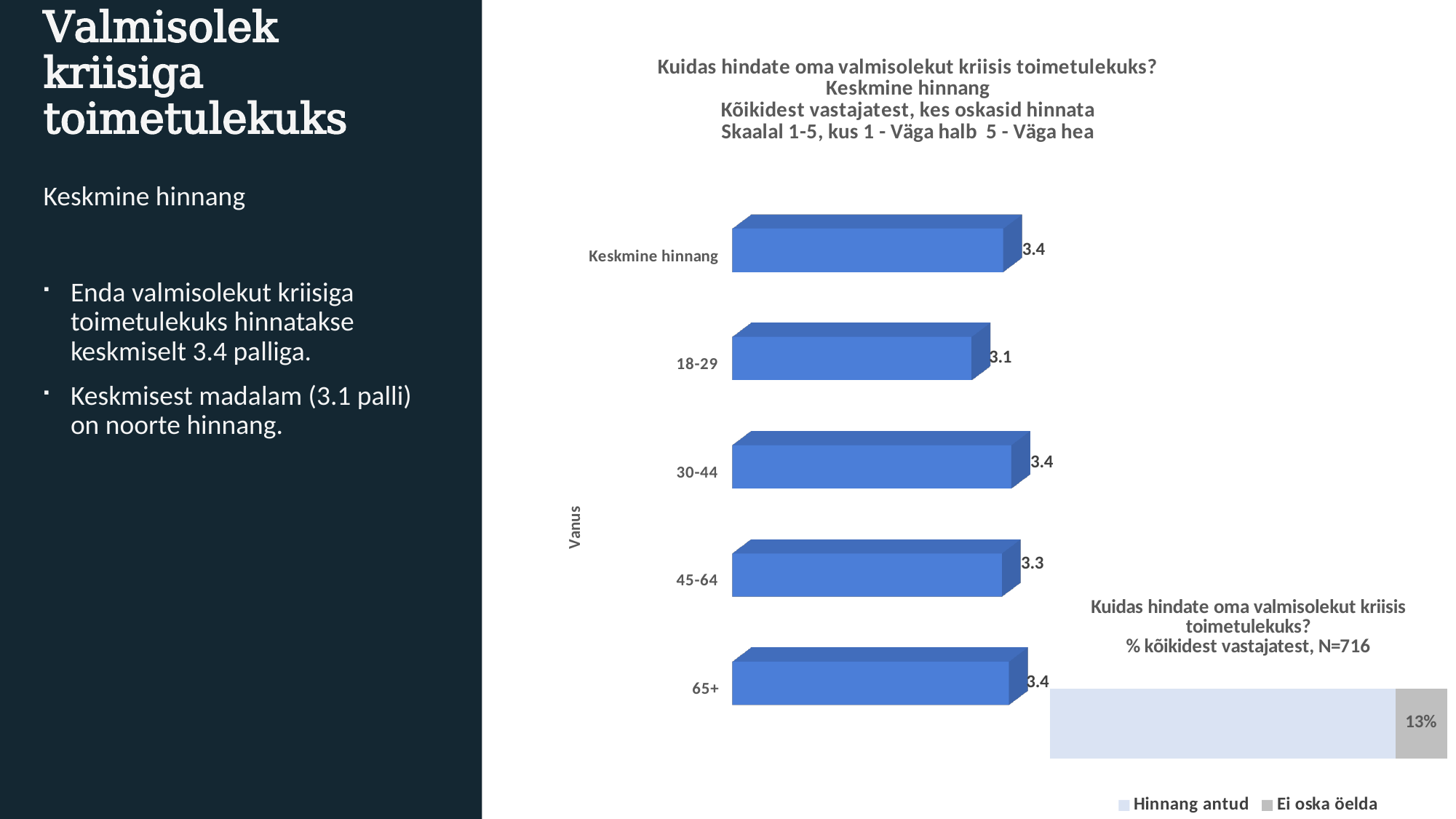
How many bars are plotted in the main bar chart (Keskmine hinnang)? 5 In the main bar chart (Keskmine hinnang), what is the value for the 65+ age group? 3.4 In the main bar chart (Keskmine hinnang), what is the difference between the 30-44 value and the 18-29 value? 0.3 What is the label of the vertical axis in the main bar chart (Keskmine hinnang)? Vanus In the main bar chart (Keskmine hinnang), what is the value for the 18-29 age group? 3.1 In the main bar chart (Keskmine hinnang), which is larger: the value for 45-64 or the value for 18-29? 45-64 In the main bar chart (Keskmine hinnang), which age group has the lowest average rating? 18-29 How many series does the legend of the small chart at the bottom right (% kõikidest vastajatest, N=716) list? 2 In the main bar chart (Keskmine hinnang), what is the value of the overall 'Keskmine hinnang' bar? 3.4 In the small chart at the bottom right (% kõikidest vastajatest, N=716), what is the value for 'Ei oska öelda'? 13% In the main bar chart (Keskmine hinnang), what is the value for the 45-64 age group? 3.3 What type of chart is the main chart titled 'Kuidas hindate oma valmisolekut kriisis toimetulekuks? Keskmine hinnang'? Bar chart